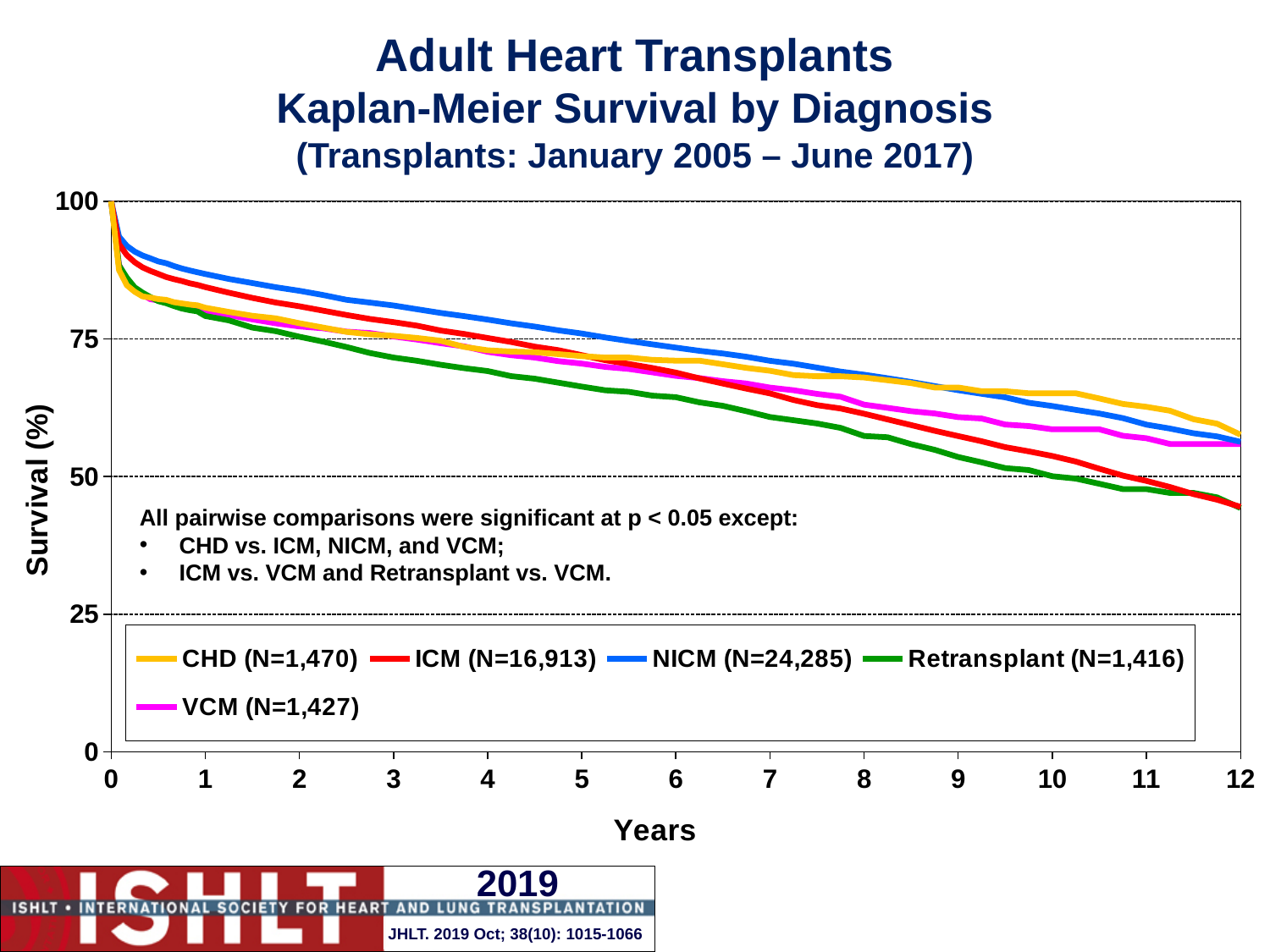
What kind of chart is shown on the slide? line chart What is the N for the NICM series in the legend? 24,285 Is the survival value for NICM at 12 years greater or less than 50? greater How many series does the legend list? 5 Is the survival value for ICM at 12 years greater or less than 50? less What is the label of the y axis? Survival (%) Which diagnosis group has the smallest N in the legend? Retransplant What is the N for the Retransplant series in the legend? 1,416 Which diagnosis group has the largest N in the legend? NICM At 8 years, which has higher survival, NICM or Retransplant? NICM Do the survival curves rise or fall as years increase? fall Which diagnosis group has the lowest survival at 6 years? Retransplant